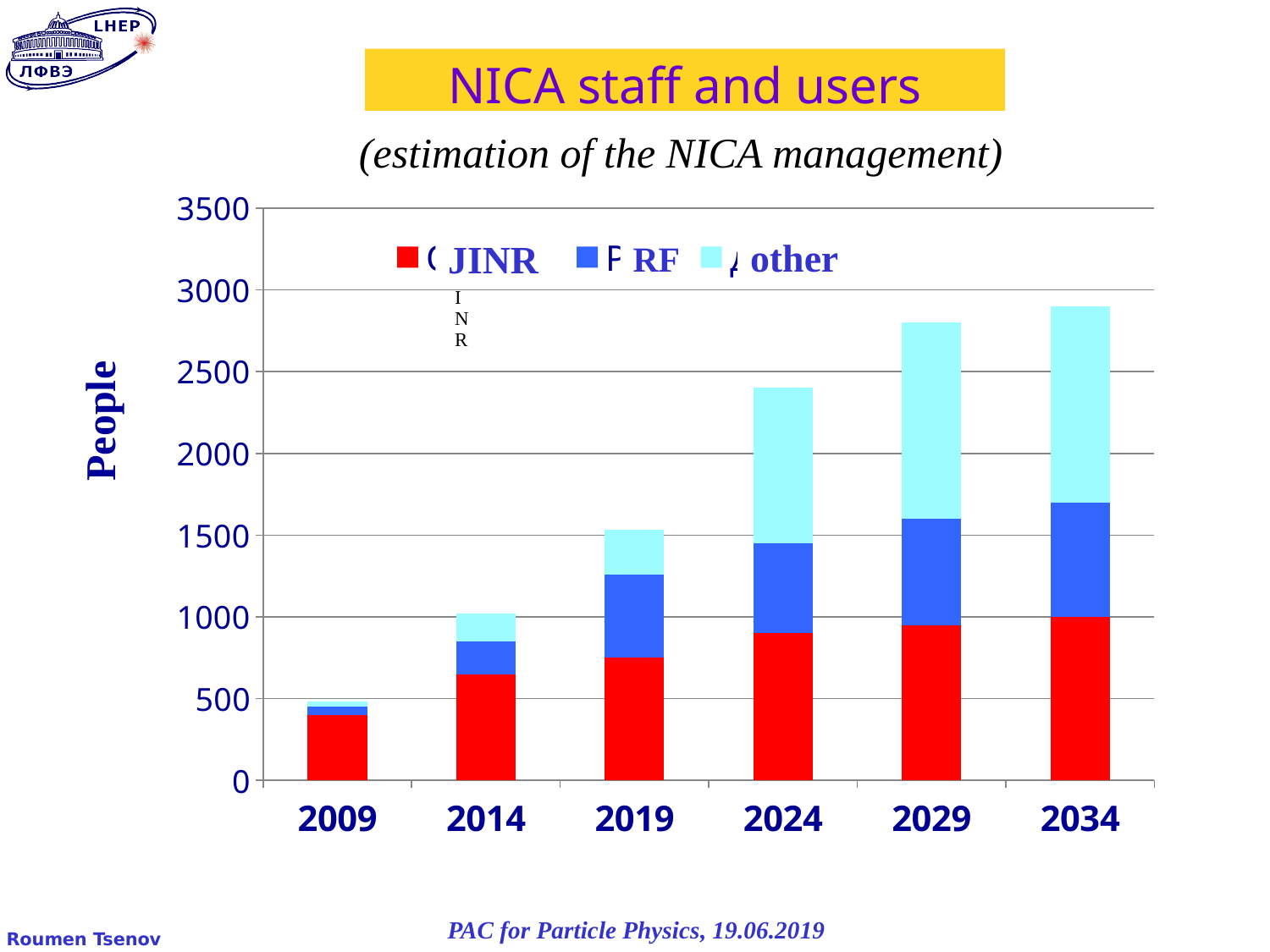
What kind of chart is shown on the slide? stacked bar chart Which year has the shortest stacked bar? 2009 How many years are shown along the x axis? 6 Which year has the tallest stacked bar? 2034 What is the label on the y axis? People Is the total for 2009 greater or less than 500? less Is the total for 2034 greater or less than 2500? greater Which is larger, the total bar for 2024 or the total bar for 2019? 2024 How many series does the legend list? 3 Is the total for 2024 greater or less than 2500? less Do the total bar heights rise or fall from 2009 to 2034? rise Which series is shown in red? JINR